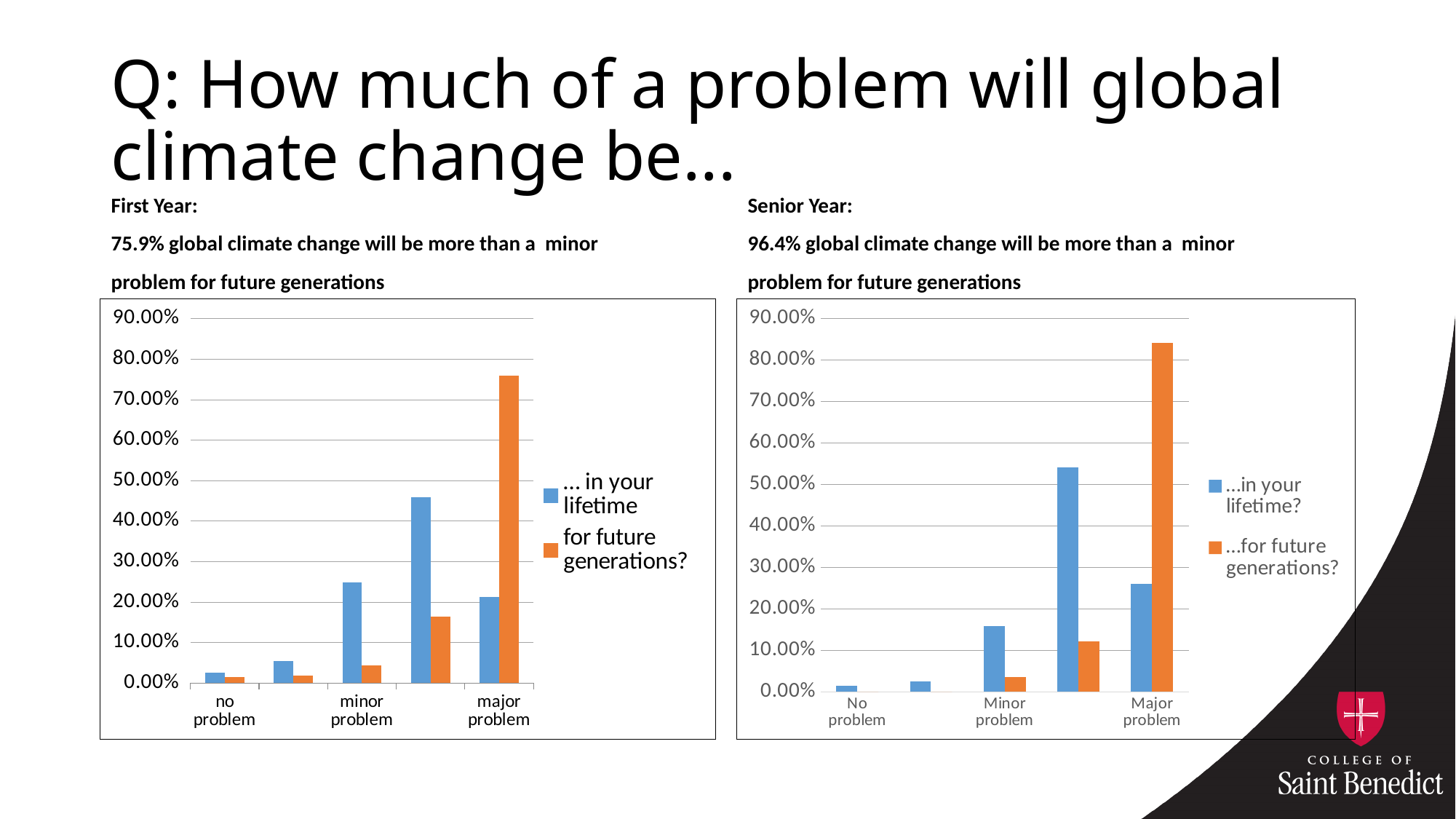
In the Senior Year chart, which category has the tallest bar for the '...for future generations?' series? Major problem What colour are the '...for future generations?' bars in the Senior Year chart? orange How many series does the legend of the Senior Year chart list? 2 In the First Year chart, which category has the tallest bar for the 'for future generations?' series? major problem In the First Year chart, is the 'for future generations?' value for major problem greater or less than 70.00%? greater In the First Year chart, for major problem, which series has the larger value: '... in your lifetime' or 'for future generations?'? for future generations? What kind of chart is the First Year chart on the left? bar chart In the First Year chart, is the '... in your lifetime' value for major problem greater or less than 30.00%? less In the Senior Year chart, is the '...for future generations?' value for Major problem greater or less than 80.00%? greater In the First Year chart, which category has the lowest 'for future generations?' value? no problem In the Senior Year chart, for Minor problem, which series has the larger value: '...in your lifetime?' or '...for future generations?'? ...in your lifetime?